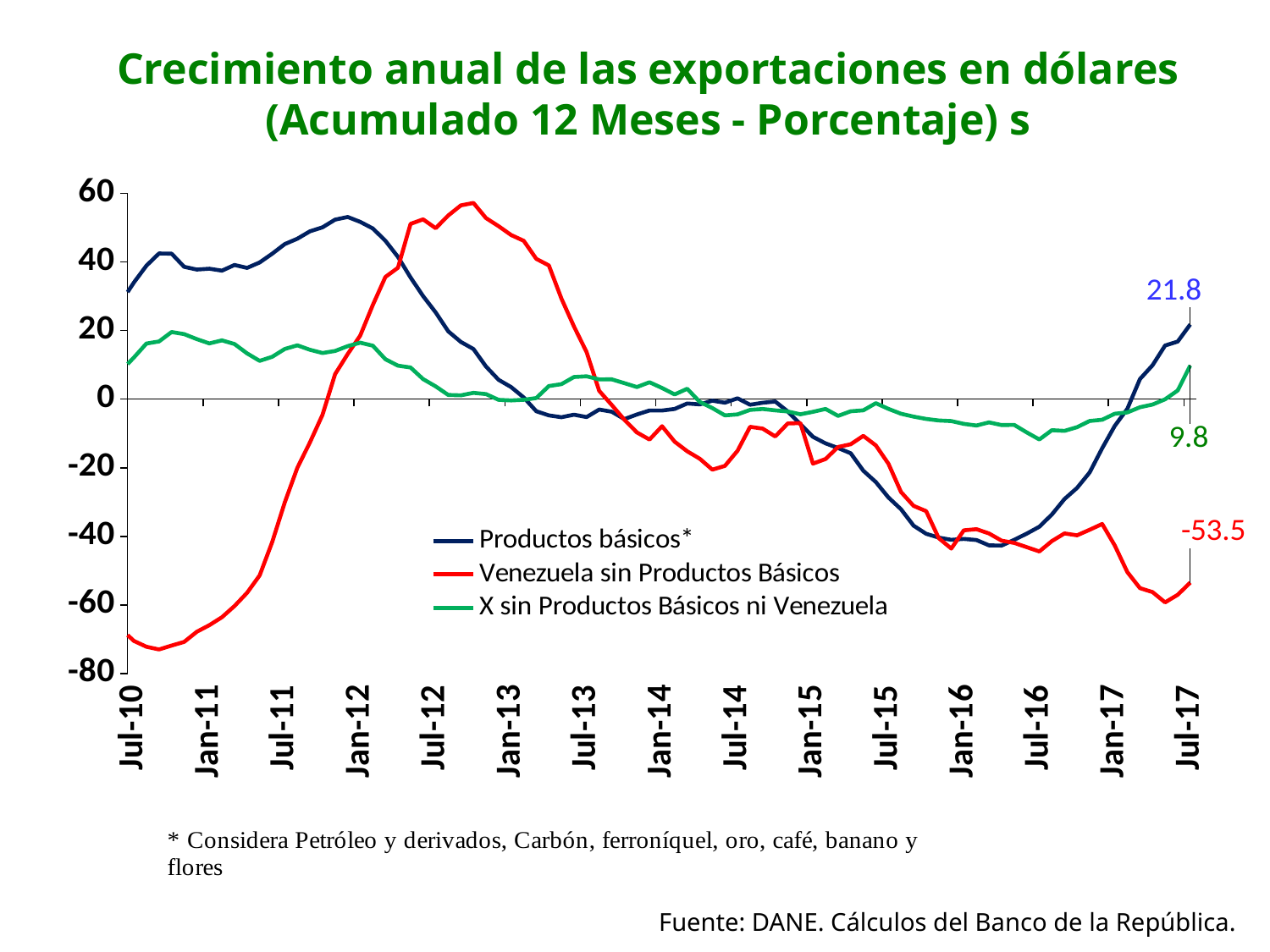
What is the value of the X sin Productos Básicos ni Venezuela series at Jul-17? 9.8 At Jul-17, which is larger: the Productos básicos* value or the Venezuela sin Productos Básicos value? Productos básicos* What is the value of the Productos básicos* series at Jul-17? 21.8 What is the difference between the Productos básicos* value and the X sin Productos Básicos ni Venezuela value at Jul-17? 12.0 How many series does the legend list? 3 What kind of chart is shown on the slide? Line chart Does the Venezuela sin Productos Básicos series rise or fall between Jul-10 and Jan-13? Rise What is the value of the Venezuela sin Productos Básicos series at Jul-17? -53.5 At Jul-17, which series has the highest value? Productos básicos* At Jul-17, which series has the lowest value? Venezuela sin Productos Básicos Is the value of the Productos básicos* series at Jan-12 greater or less than 40? greater Is the value of the Venezuela sin Productos Básicos series at Jul-10 greater or less than -60? less